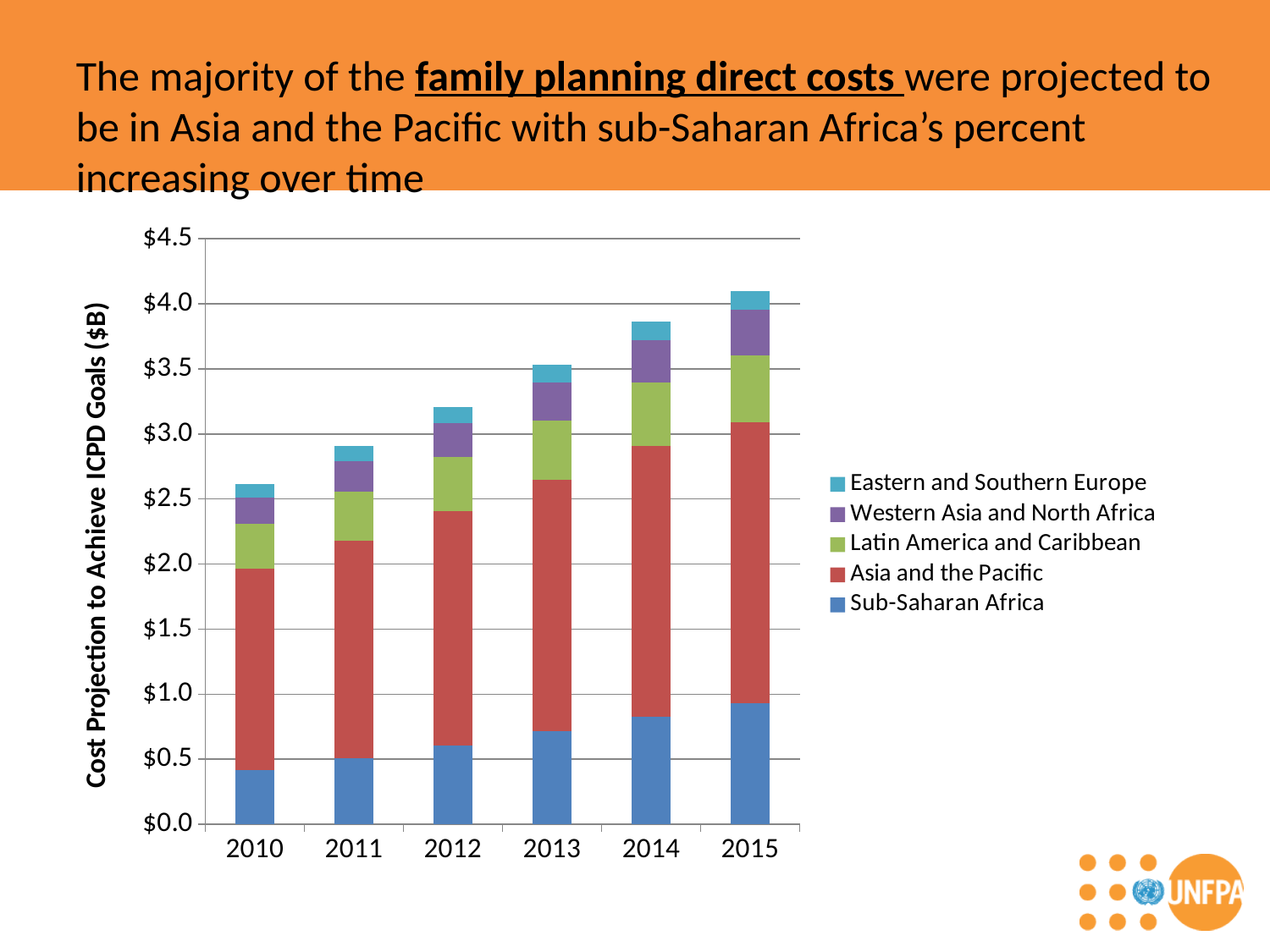
Which year has the lowest total cost projection? 2010 How many years are shown along the x axis of the chart? 6 In 2015, which region has the larger cost projection: Asia and the Pacific or Sub-Saharan Africa? Asia and the Pacific Is the total cost projection for 2010 greater or less than $2.5? greater How many series does the chart's legend list? 5 What is the label on the chart's vertical axis? Cost Projection to Achieve ICPD Goals ($B) Is the total cost projection for 2014 greater or less than $4.0? less Which year has the highest total cost projection? 2015 What kind of chart is shown on the slide? Stacked bar chart Is the total cost projection for 2015 greater or less than $4.0? greater Do the total cost projections rise or fall from 2010 to 2015? Rise